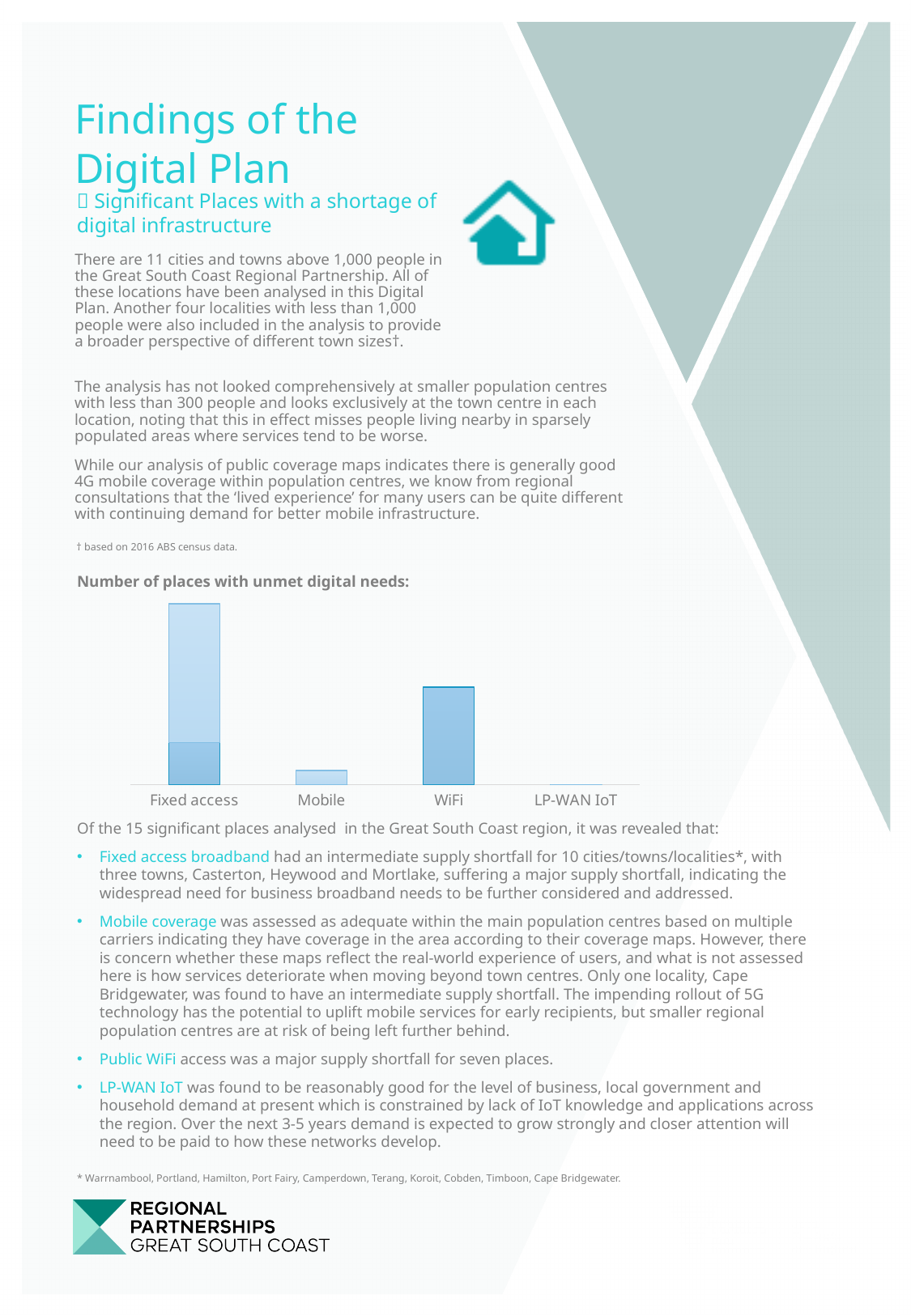
Which category has the tallest bar in the 'Number of places with unmet digital needs' chart? Fixed access In the 'Number of places with unmet digital needs' chart, which is larger, Fixed access or WiFi? Fixed access Which category has the lowest value in the 'Number of places with unmet digital needs' chart? LP-WAN IoT What is the title of the chart on the slide? Number of places with unmet digital needs: In the 'Number of places with unmet digital needs' chart, which is larger, Mobile or LP-WAN IoT? Mobile How many categories are shown on the x axis of the 'Number of places with unmet digital needs' chart? 4 Which category in the 'Number of places with unmet digital needs' chart is drawn as a stacked bar with two segments? Fixed access What kind of chart is shown under the heading 'Number of places with unmet digital needs'? bar chart In the 'Number of places with unmet digital needs' chart, which is larger, WiFi or Mobile? WiFi